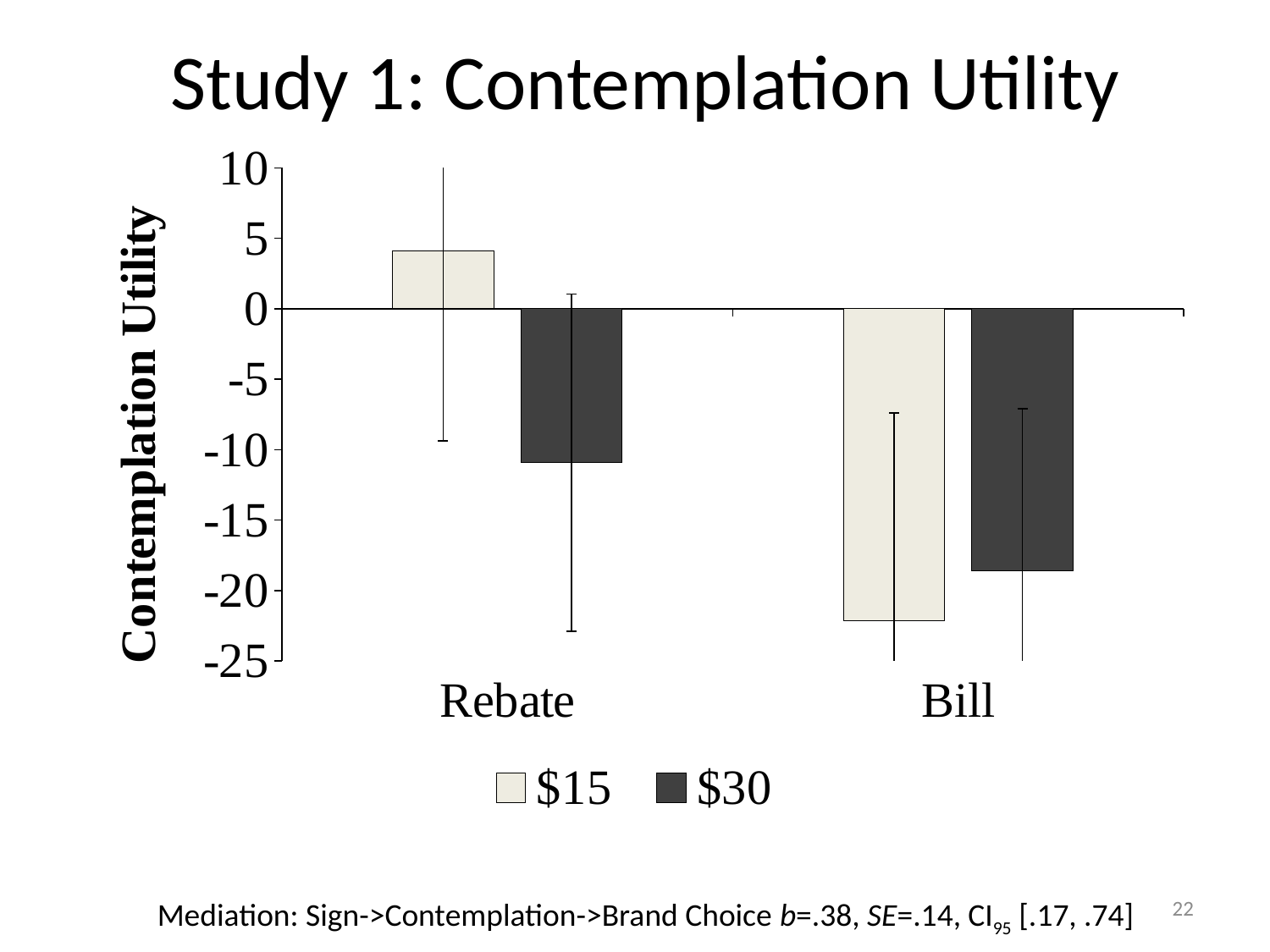
In the Rebate category, which series has the larger value, $15 or $30? $15 What kind of chart is shown on the slide? bar chart How many series does the chart's legend list? 2 Is the value for $15 in the Bill category greater or less than -20? less What are the two series listed in the chart's legend? $15 and $30 Is the value for $15 in the Rebate category greater or less than 0? greater Is the value for $30 in the Bill category greater or less than -15? less How many categories are shown on the x axis of the chart? 2 Which category and series combination has the highest contemplation utility? Rebate, $15 What is the label of the chart's vertical axis? Contemplation Utility Which category and series combination has the lowest contemplation utility? Bill, $15